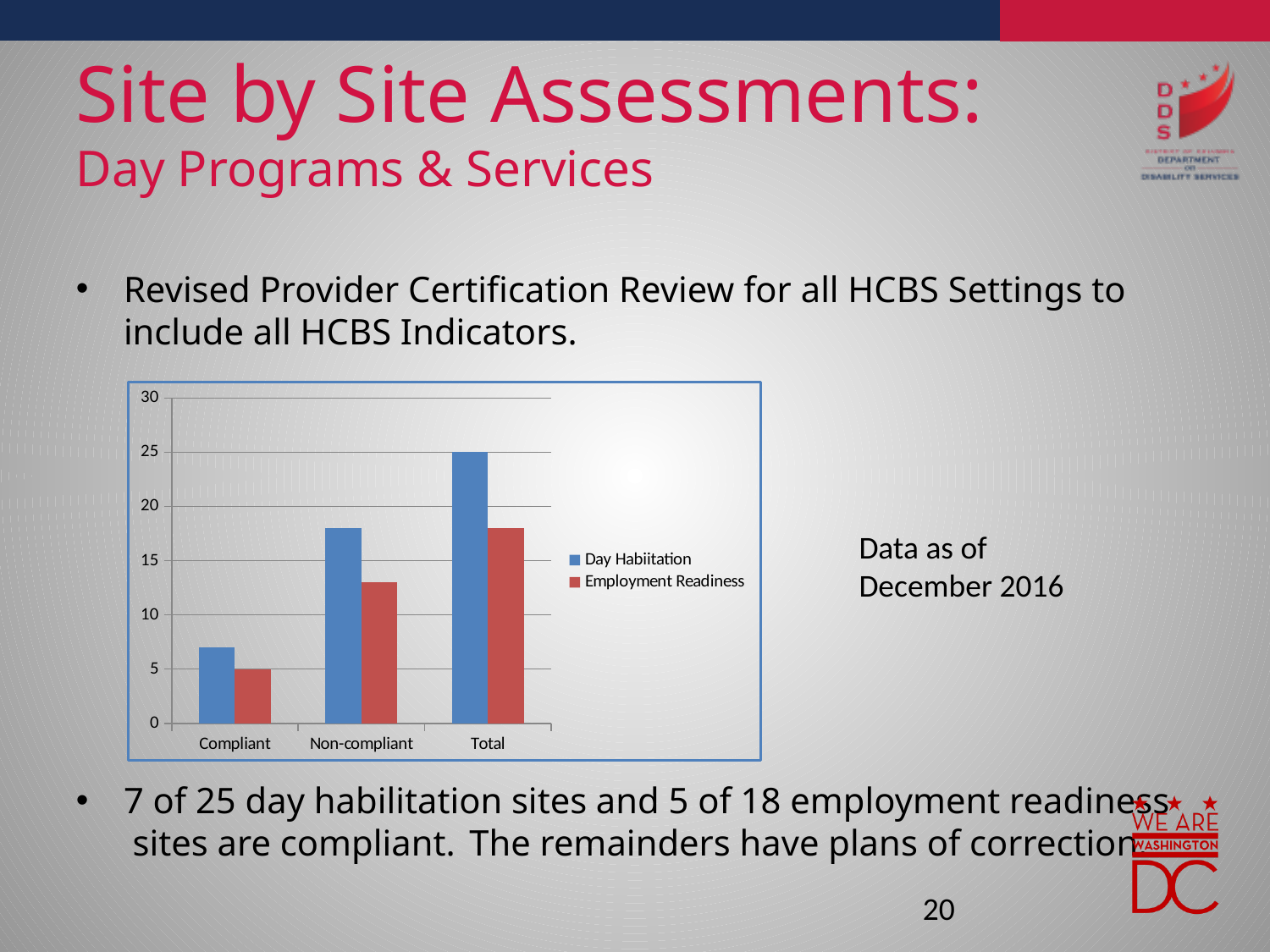
What kind of chart is shown on the slide? bar chart How many categories are shown on the x axis of the chart? 3 Which category has the highest value for the Day Habilitation series? Total How many series does the chart legend list? 2 What is the Total value for Day Habilitation in the chart? 25 Is the Compliant value for Day Habilitation greater or less than 10? less What is the Compliant value for Employment Readiness in the chart? 5 What colour are the Day Habilitation bars in the chart? blue Which category has the lowest value for the Employment Readiness series? Compliant Is the Non-compliant value for Day Habilitation greater or less than 15? greater Is the Non-compliant value for Employment Readiness greater or less than 15? less In the Compliant category, which series has the larger value, Day Habilitation or Employment Readiness? Day Habilitation